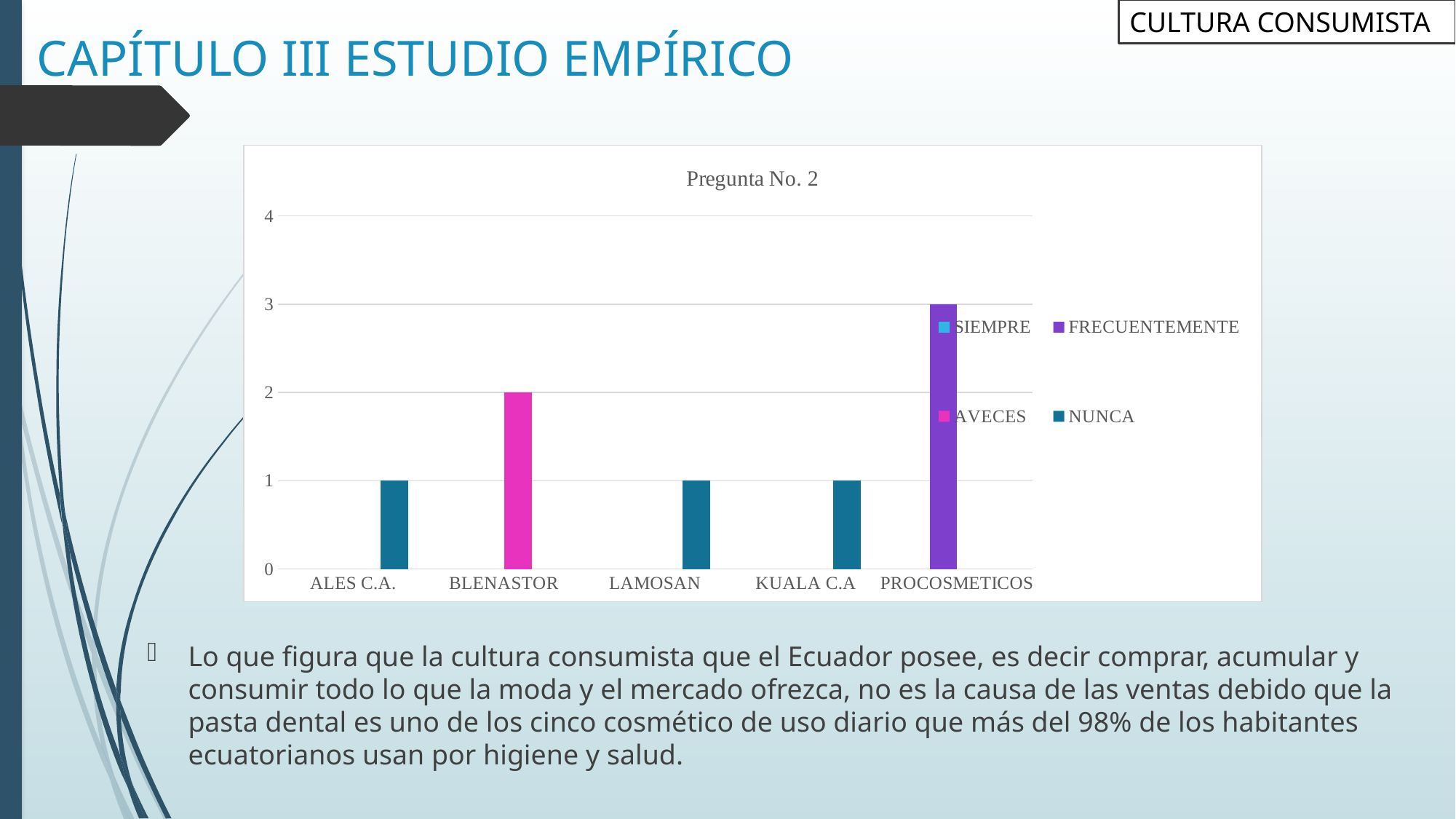
How many series does the chart's legend list? 4 What is the value of the bar for LAMOSAN? 1 What is the difference between the bar for PROCOSMETICOS and the bar for BLENASTOR? 1 Which legend series does the bar for BLENASTOR belong to? AVECES What kind of chart is shown on the slide? bar chart Which category has the highest bar in the chart? PROCOSMETICOS Is the value for PROCOSMETICOS greater or less than 2? greater How many categories are shown on the x axis of the chart? 5 What is the title of the chart? Pregunta No. 2 What is the value of the bar for PROCOSMETICOS? 3 What is the value of the bar for BLENASTOR? 2 Which is larger, the bar for BLENASTOR or the bar for KUALA C.A? BLENASTOR